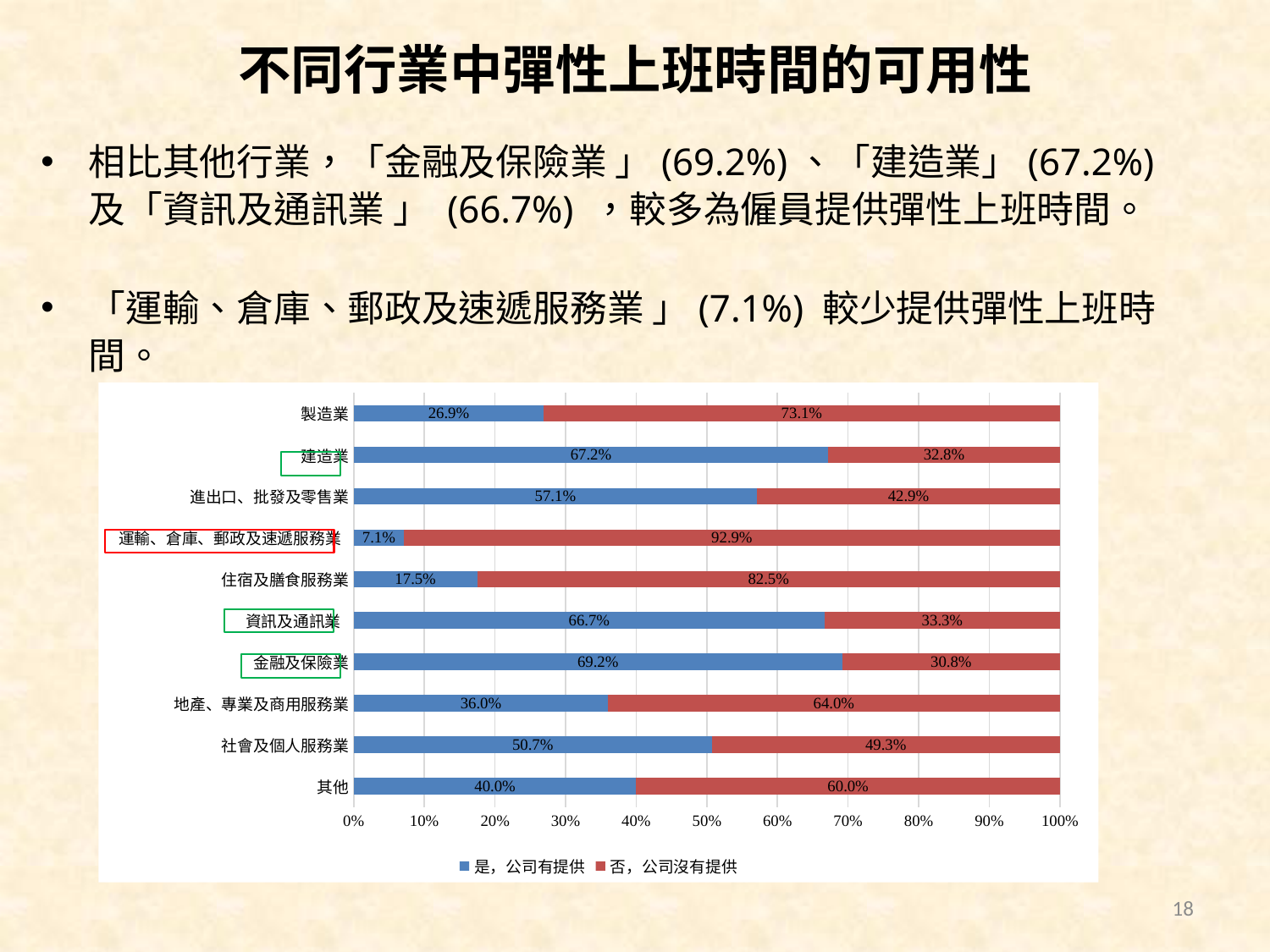
Which industry has the lowest value for 「是，公司有提供」? 運輸、倉庫、郵政及速遞服務業 What is the value of 「否，公司沒有提供」 for 住宿及膳食服務業? 82.5% How many industries are shown in the chart? 10 Which industry has the highest value for 「是，公司有提供」? 金融及保險業 How many series does the legend list? 2 What is the value of 「是，公司有提供」 for 社會及個人服務業? 50.7% Which colour represents 「否，公司沒有提供」 in the chart? Red Which has a larger 「否，公司沒有提供」 value: 地產、專業及商用服務業 or 其他? 地產、專業及商用服務業 What is the value of 「是，公司有提供」 for 製造業? 26.9% What is the difference between the 「是，公司有提供」 values for 建造業 and 資訊及通訊業? 0.5% What is the total of the stacked bar for 進出口、批發及零售業? 100% What kind of chart is shown on the slide? Stacked bar chart